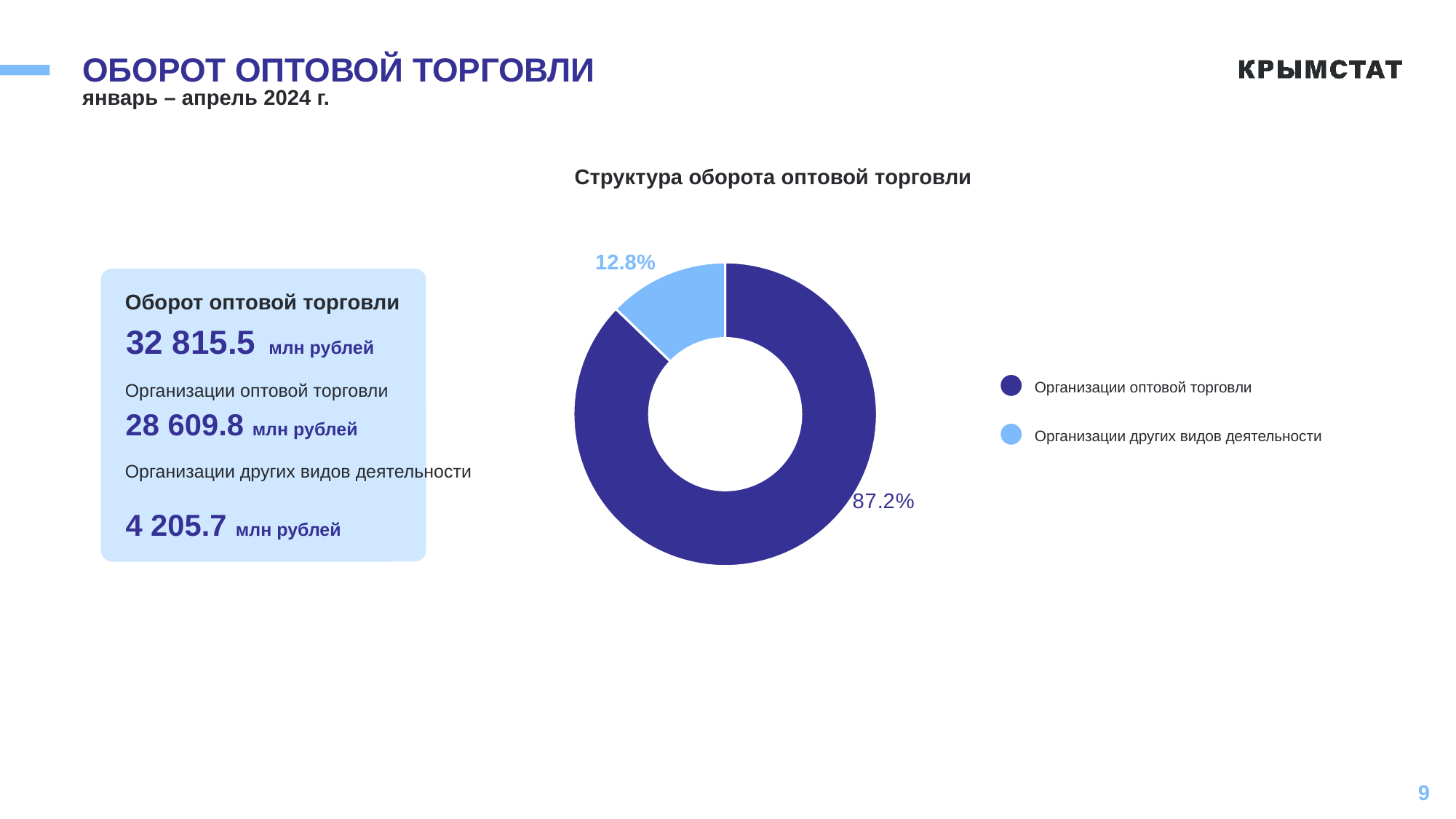
Which slice is larger: 'Организации оптовой торговли' or 'Организации других видов деятельности'? Организации оптовой торговли What share of the donut chart does 'Организации других видов деятельности' account for? 12.8% What share of the donut chart does 'Организации оптовой торговли' account for? 87.2% How many slices does the chart have? 2 Which category has the largest slice in the chart? Организации оптовой торговли Is the share for 'Организации других видов деятельности' greater or less than 50%? less Which colour represents 'Организации других видов деятельности' in the chart? Light blue Which category has the smallest slice in the chart? Организации других видов деятельности How many entries does the chart legend list? 2 What is the title of the chart? Структура оборота оптовой торговли What is the difference in percentage points between the two slices of the chart? 74.4 What type of chart is shown on the slide? Donut (pie) chart